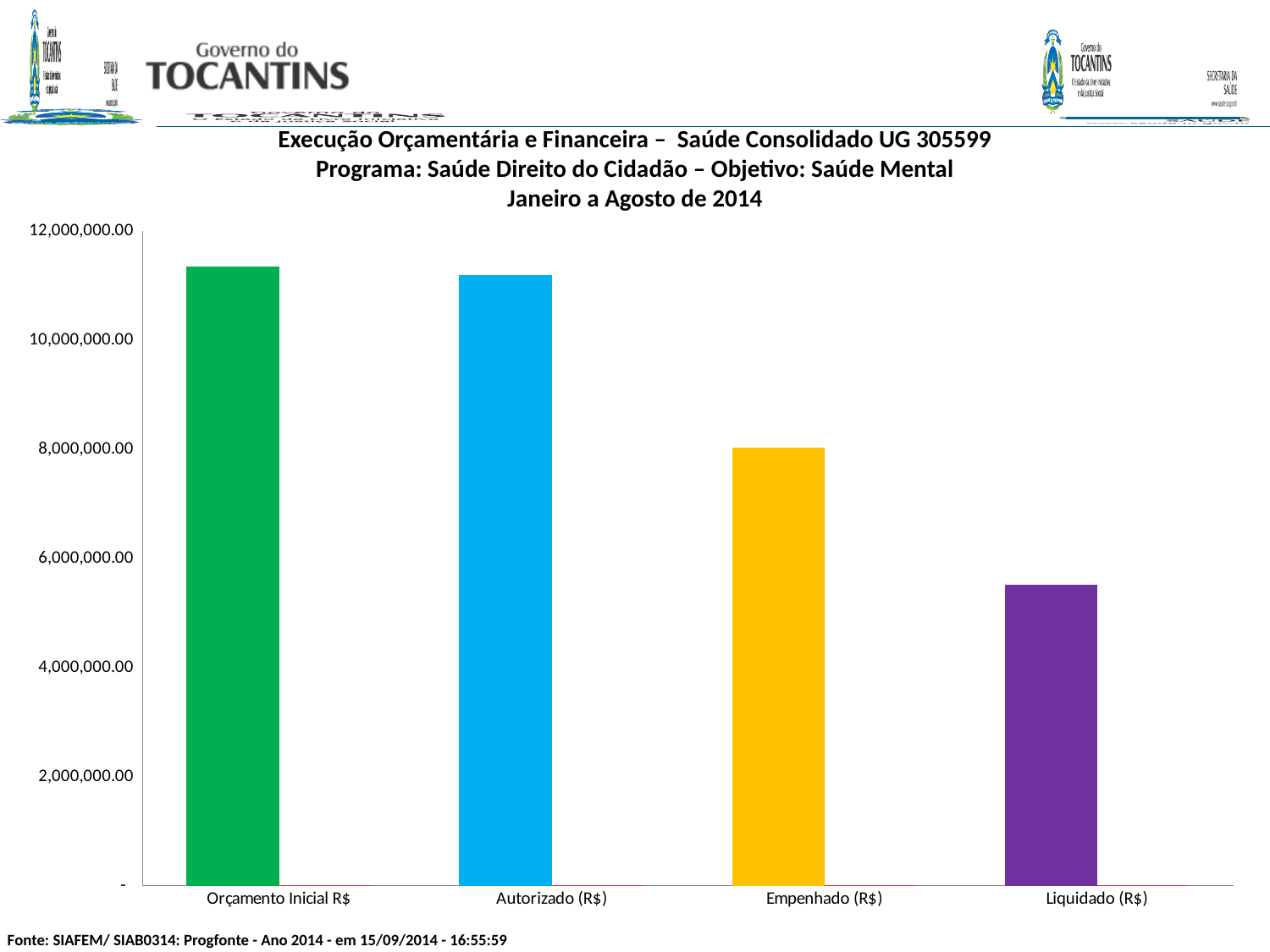
What kind of chart is shown on the slide? Bar chart Do the values rise or fall moving from left to right across the categories? fall Is the value for Empenhado (R$) greater or less than 6,000,000.00? greater Is the value for Autorizado (R$) greater or less than 12,000,000.00? less Which category has the lowest value in the chart? Liquidado (R$) Which is larger, the value for Autorizado (R$) or the value for Empenhado (R$)? Autorizado (R$) How many categories are plotted in the chart? 4 Is the value for Liquidado (R$) greater or less than 6,000,000.00? less What colour is the bar for Empenhado (R$)? Yellow Which is larger, the value for Empenhado (R$) or the value for Liquidado (R$)? Empenhado (R$) What period does the chart title say the data covers? Janeiro a Agosto de 2014